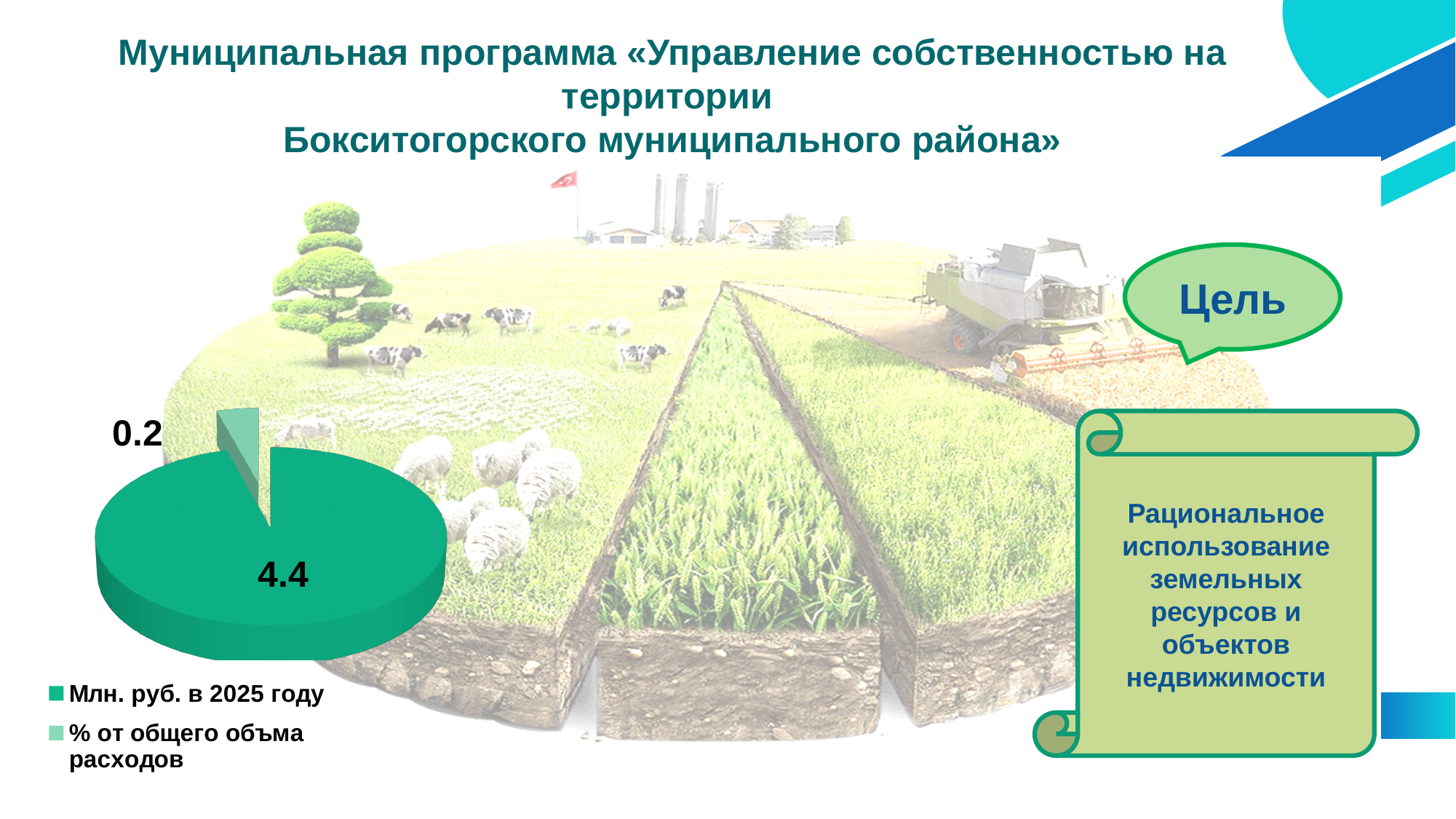
What kind of chart is shown on the slide? Pie chart How many entries does the legend of the pie chart list? 2 How many slices does the pie chart have? 2 Which legend entry is shown in the lighter green colour in the pie chart? % от общего объма расходов Which legend entry is shown in the darker green colour in the pie chart? Млн. руб. в 2025 году Which is larger in the pie chart: the value for "Млн. руб. в 2025 году" or the value for "% от общего объема расходов"? Млн. руб. в 2025 году Which slice of the pie chart has the smallest value? % от общего объма расходов What value is shown for the slice labelled "Млн. руб. в 2025 году" in the pie chart? 4.4 Which slice of the pie chart has the largest value? Млн. руб. в 2025 году What value is shown for the slice labelled "% от общего объема расходов" in the pie chart? 0.2 What is the difference between the two values shown on the pie chart, 4.4 and 0.2? 4.2